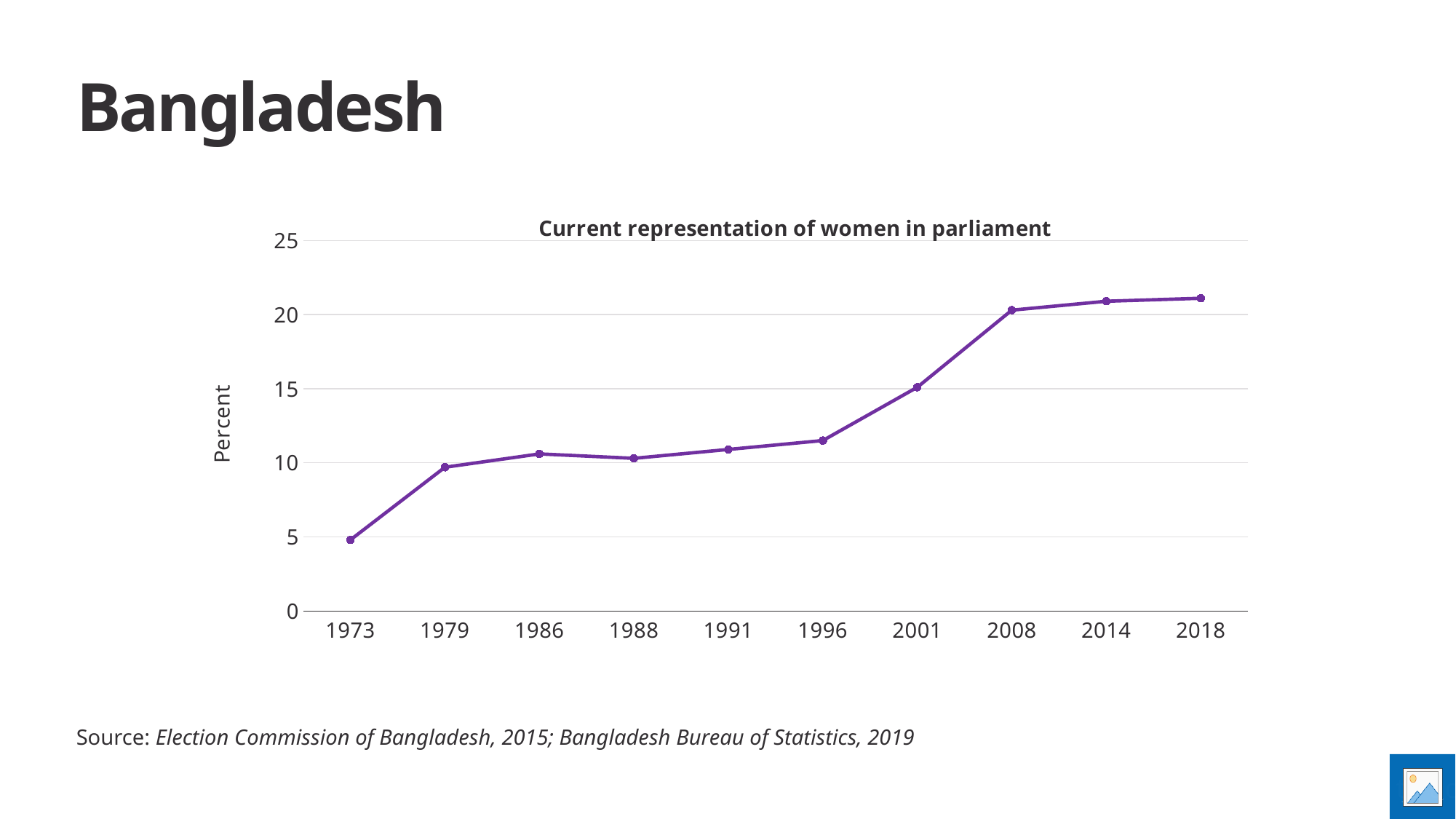
What is the title of the chart? Current representation of women in parliament How many years are plotted on the x axis? 10 Which year has the lowest representation of women in parliament? 1973 Is the value for 1996 greater or less than 10? greater What kind of chart is shown on the slide? line chart Is the value for 2018 greater or less than 20? greater Which year has the larger value, 1996 or 2001? 2001 Is the value for 2001 greater or less than 20? less What is the label on the y axis of the chart? Percent Do the values generally rise or fall from 1973 to 2018? rise